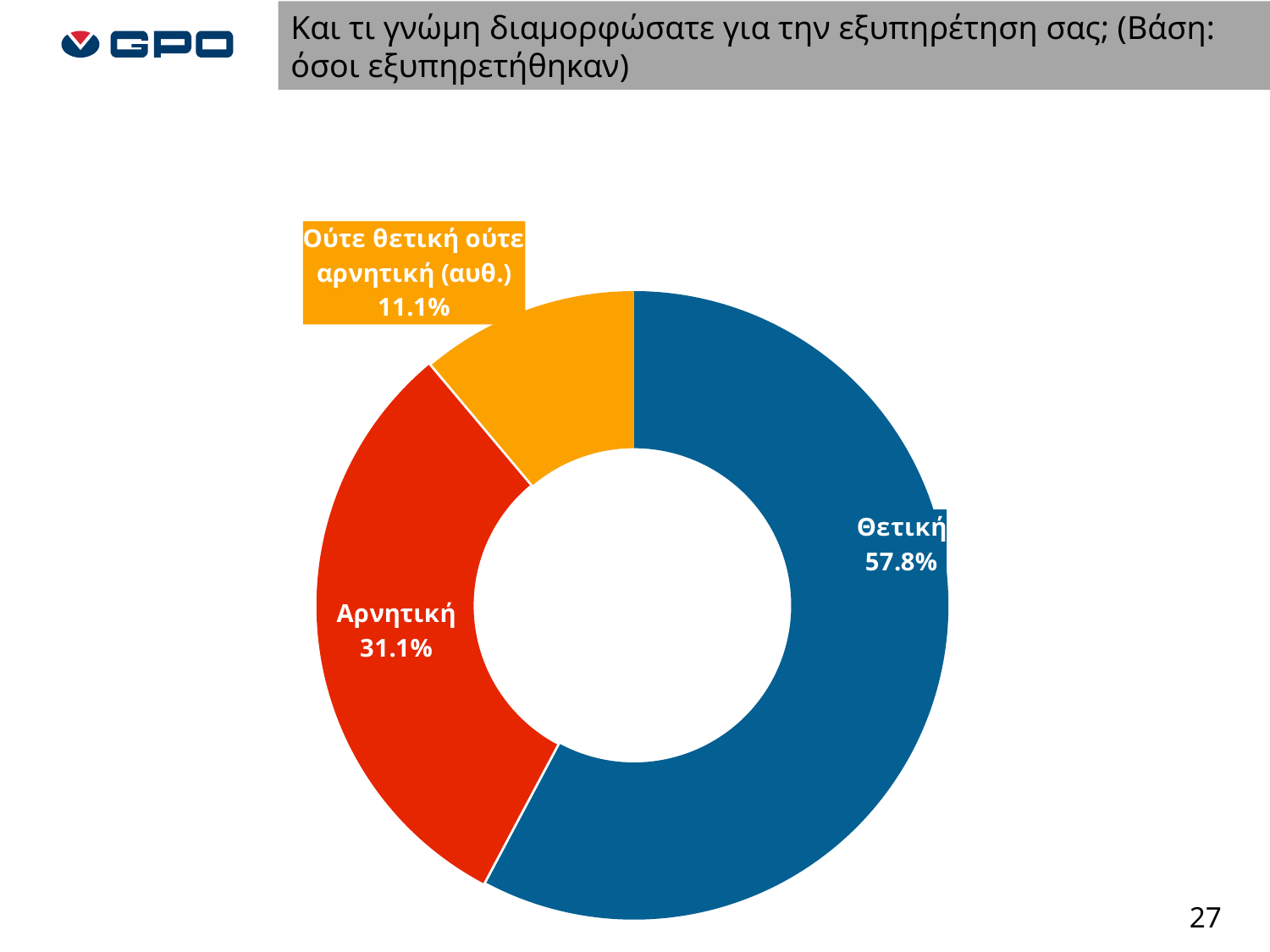
What colour is the 'Αρνητική' segment of the chart? Red What kind of chart is shown on the slide? Doughnut (pie) chart Which category has the largest share of the chart? Θετική How many categories are shown in the chart? 3 Which is larger: the share for 'Αρνητική' or the share for 'Ούτε θετική ούτε αρνητική (αυθ.)'? Αρνητική What is the difference in percentage points between 'Θετική' and 'Αρνητική'? 26.7 What is the difference in percentage points between 'Αρνητική' and 'Ούτε θετική ούτε αρνητική (αυθ.)'? 20 What percentage of respondents gave a 'Θετική' (positive) opinion? 57.8% Which category has the smallest share of the chart? Ούτε θετική ούτε αρνητική (αυθ.) What colour is the 'Θετική' segment of the chart? Blue What percentage of respondents answered 'Ούτε θετική ούτε αρνητική (αυθ.)'? 11.1% What percentage of respondents gave an 'Αρνητική' (negative) opinion? 31.1%